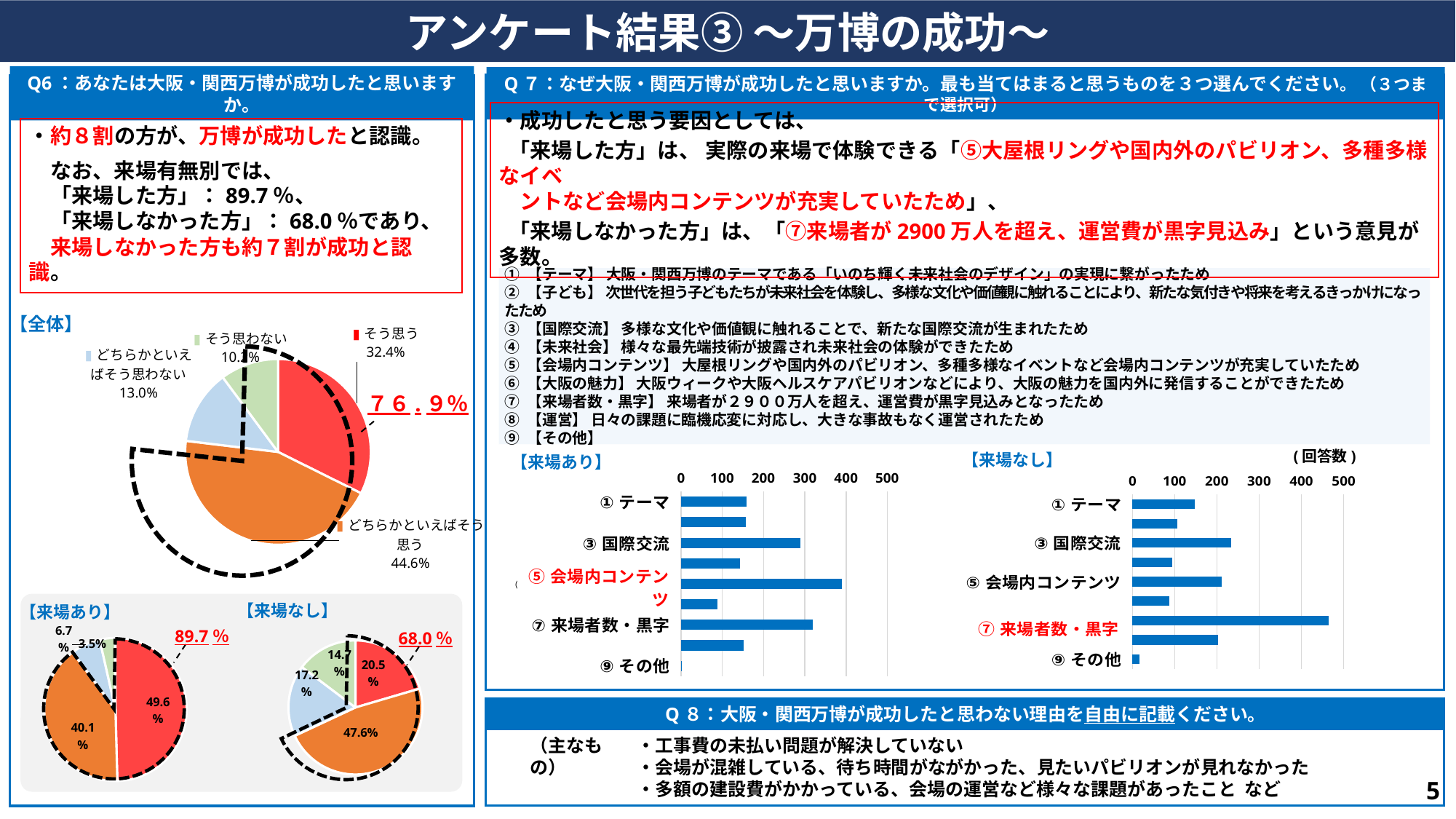
In the 【全体】 pie chart, what percentage is shown for どちらかといえばそう思う? 44.6% In the 【来場あり】 pie chart at the bottom left, what is the largest slice's percentage? 49.6% In the 【来場なし】 bar chart on the right, which category has the highest value? ⑦ 来場者数・黒字 In the 【来場なし】 pie chart at the bottom left, what is the largest slice's percentage? 47.6% In the 【全体】 pie chart, what is the difference in percentage points between どちらかといえばそう思う and そう思う? 12.2 What kind of chart is the 【来場なし】 chart on the right side of the slide? bar chart In the 【全体】 pie chart, what percentage is shown for そう思う? 32.4% In the 【来場あり】 bar chart on the right, is the value for ⑨ その他 greater or less than 100? less In the 【来場なし】 bar chart on the right, is the value for ⑦ 来場者数・黒字 greater or less than 400? greater In the 【来場あり】 bar chart on the right, which is larger, the value for ① テーマ or ⑤ 会場内コンテンツ? ⑤ 会場内コンテンツ